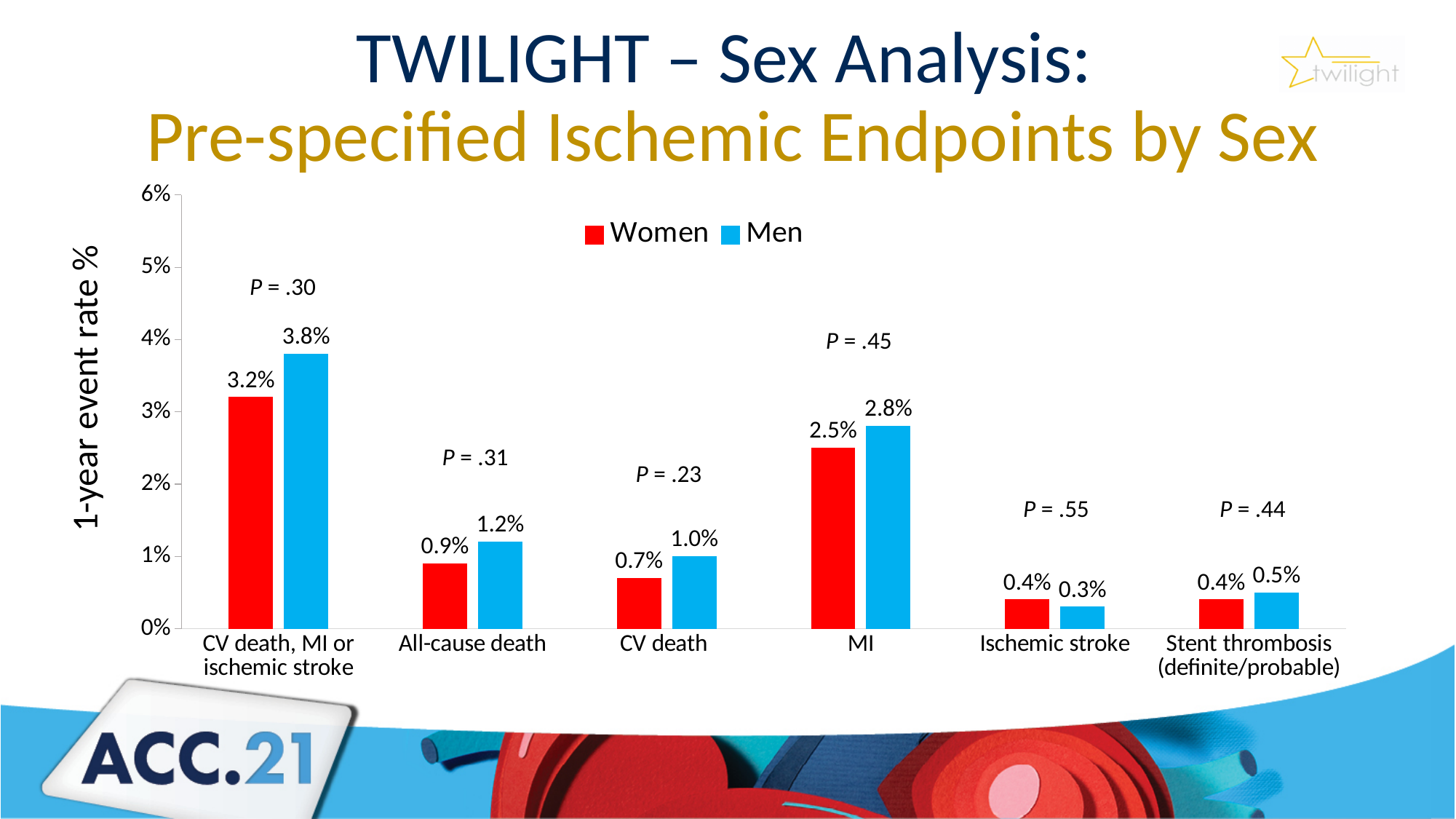
What is the 1-year event rate for Women for CV death? 0.7% What is the difference between the Men and Women event rates for CV death, MI or ischemic stroke? 0.6% What is the 1-year event rate for Women for MI? 2.5% What is the P value shown for Stent thrombosis (definite/probable)? P = .44 How many endpoint categories are shown on the x axis? 6 How many series does the legend list? 2 Which category has the lowest event rate for Men? Ischemic stroke Is the Women event rate for MI greater or less than 2%? greater Which category has the highest event rate for Men? CV death, MI or ischemic stroke For Ischemic stroke, which group has the higher event rate, Women or Men? Women What kind of chart is shown on the slide? Bar chart What is the 1-year event rate for Men for All-cause death? 1.2%